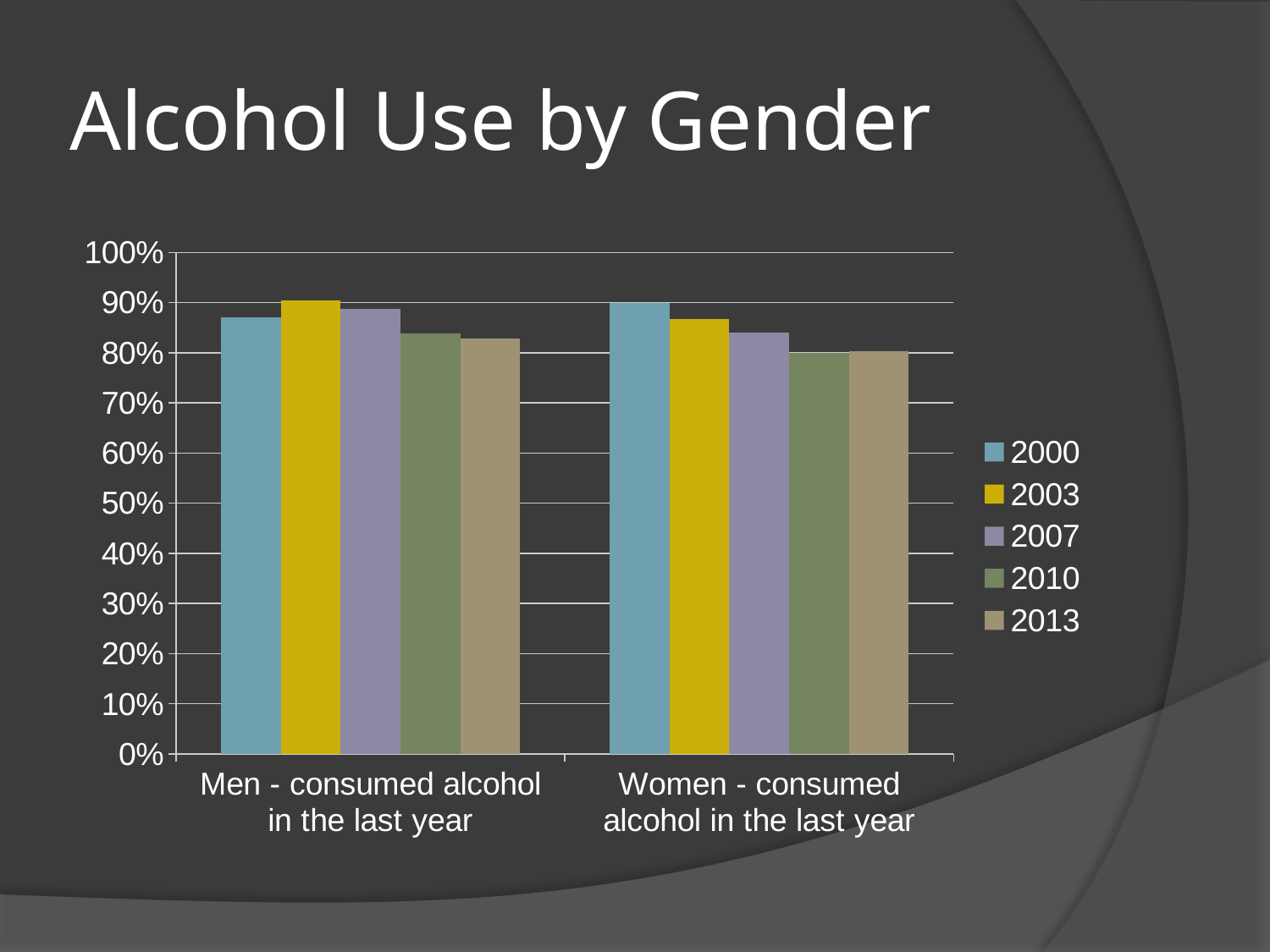
Which year has the highest value in the 'Men - consumed alcohol in the last year' category? 2003 Is the value for 2003 in the 'Men - consumed alcohol in the last year' category greater or less than 80%? greater Which years are listed in the legend? 2000, 2003, 2007, 2010, 2013 Do the values for women generally rise or fall from 2000 to 2013? fall What is the title of the chart on the slide? Alcohol Use by Gender For 2010, which is larger: the value for men or the value for women? men What kind of chart is shown on the slide? bar chart How many categories are shown on the x axis? 2 Which year has the highest value in the 'Women - consumed alcohol in the last year' category? 2000 Is the value for 2000 in the 'Men - consumed alcohol in the last year' category greater or less than 90%? less How many series does the legend list? 5 Is the value for 2007 in the 'Women - consumed alcohol in the last year' category greater or less than 90%? less